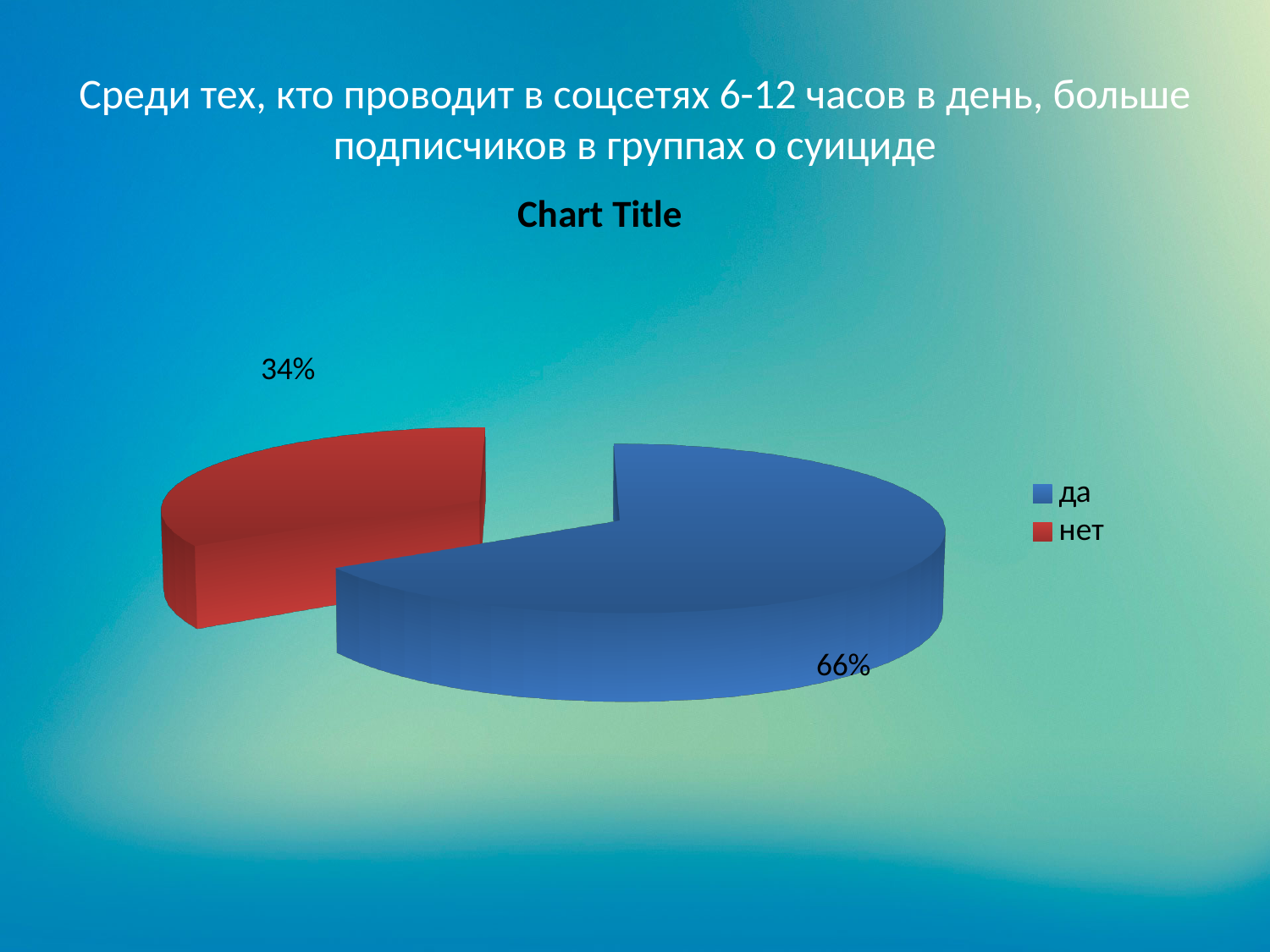
What is the difference between the shares for "да" and "нет"? 32% How many slices does the pie chart have? 2 How many entries does the legend list? 2 What kind of chart is shown on the slide? pie chart Which category has the largest share of the pie? да What is the value for "да"? 66% Which is larger, the share for "да" or the share for "нет"? да Which category has the smallest share of the pie? нет What colour is the slice for "нет"? red What is the value for "нет"? 34% What is the title shown above the chart? Chart Title